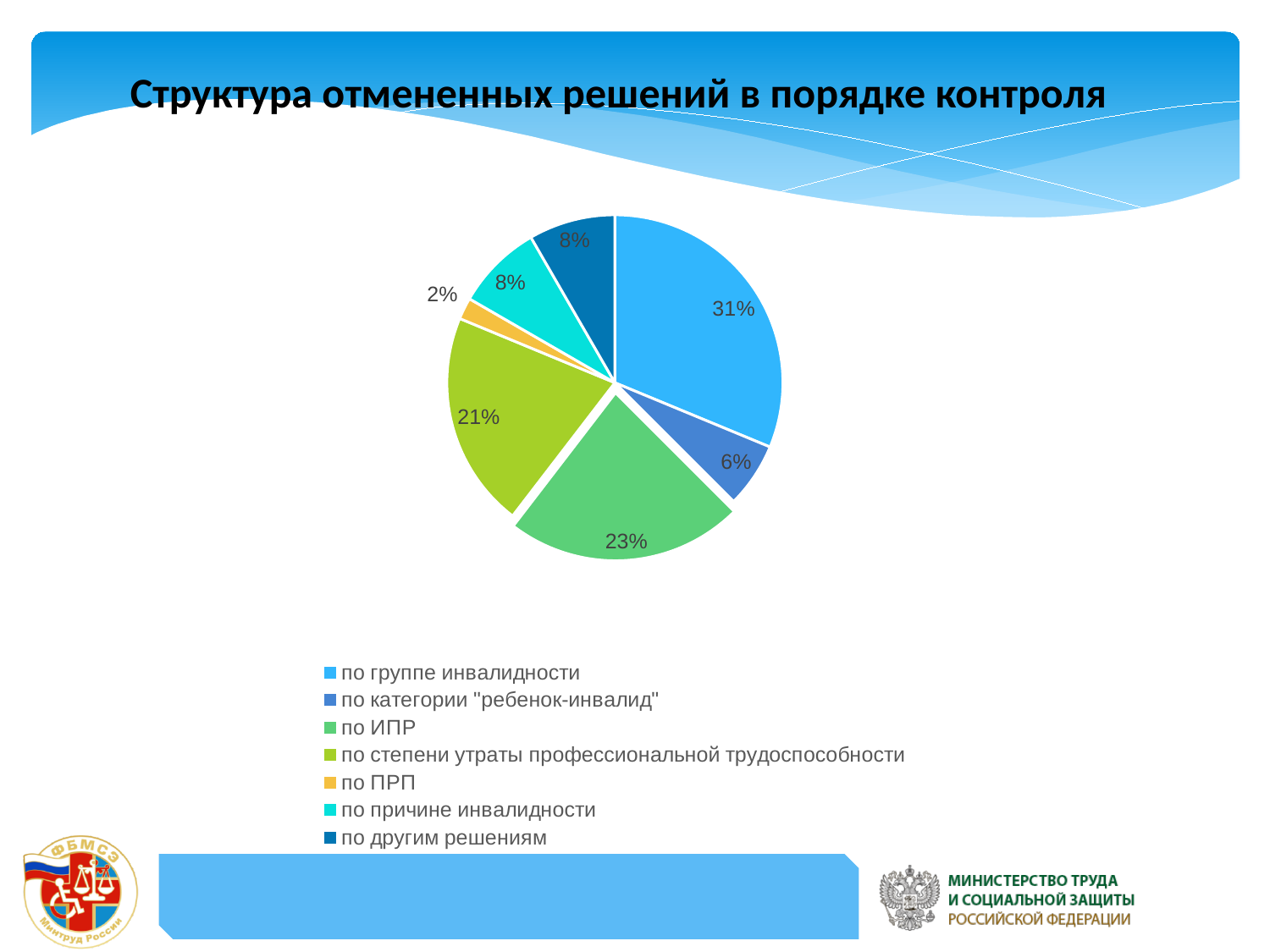
What share of the pie is "по категории "ребенок-инвалид""? 6% How many slices does the pie chart have? 7 What share of the pie is "по степени утраты профессиональной трудоспособности"? 21% What kind of chart is shown on the slide? pie chart What share of the pie is "по группе инвалидности"? 31% Which is larger: the share of "по ИПР" or the share of "по степени утраты профессиональной трудоспособности"? по ИПР What is the difference between the shares of "по группе инвалидности" and "по ИПР"? 8% Which category has the smallest share of the pie? по ПРП Which category has the largest share of the pie? по группе инвалидности What is the title of the chart? Структура отмененных решений в порядке контроля